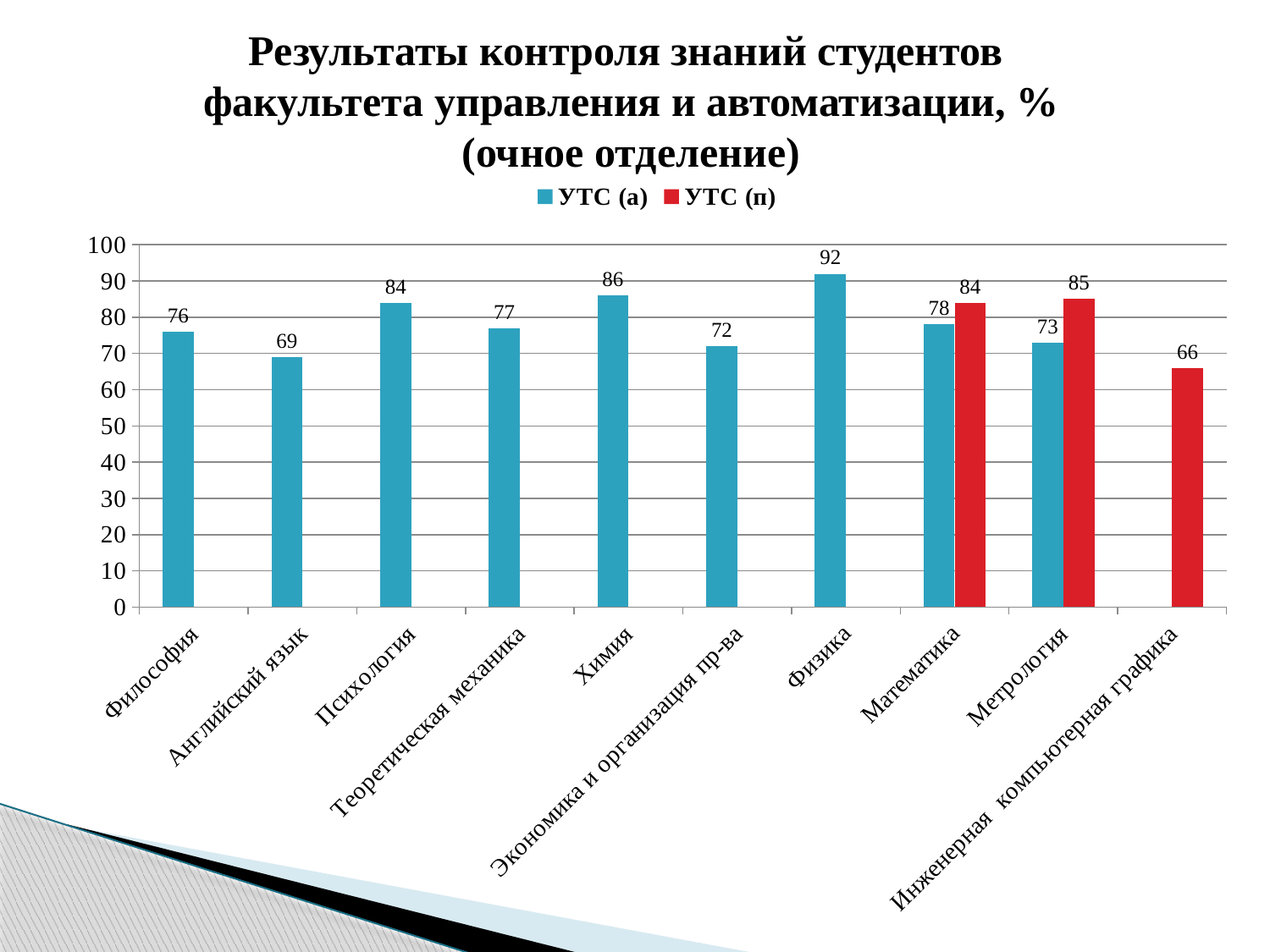
Which colour represents the УТС (п) series? Red Which category has the lowest УТС (а) value? Английский язык How many categories are shown on the x axis? 10 What kind of chart is shown on the slide? Bar chart What is the УТС (а) value for Физика? 92 How many series does the legend list? 2 What is the УТС (а) value for Английский язык? 69 What is the difference between the УТС (п) and УТС (а) values for Метрология? 12 Which is larger for Математика: the УТС (а) value or the УТС (п) value? УТС (п) What is the УТС (п) value for Инженерная компьютерная графика? 66 What is the УТС (п) value for Метрология? 85 Which category has the highest УТС (а) value? Физика